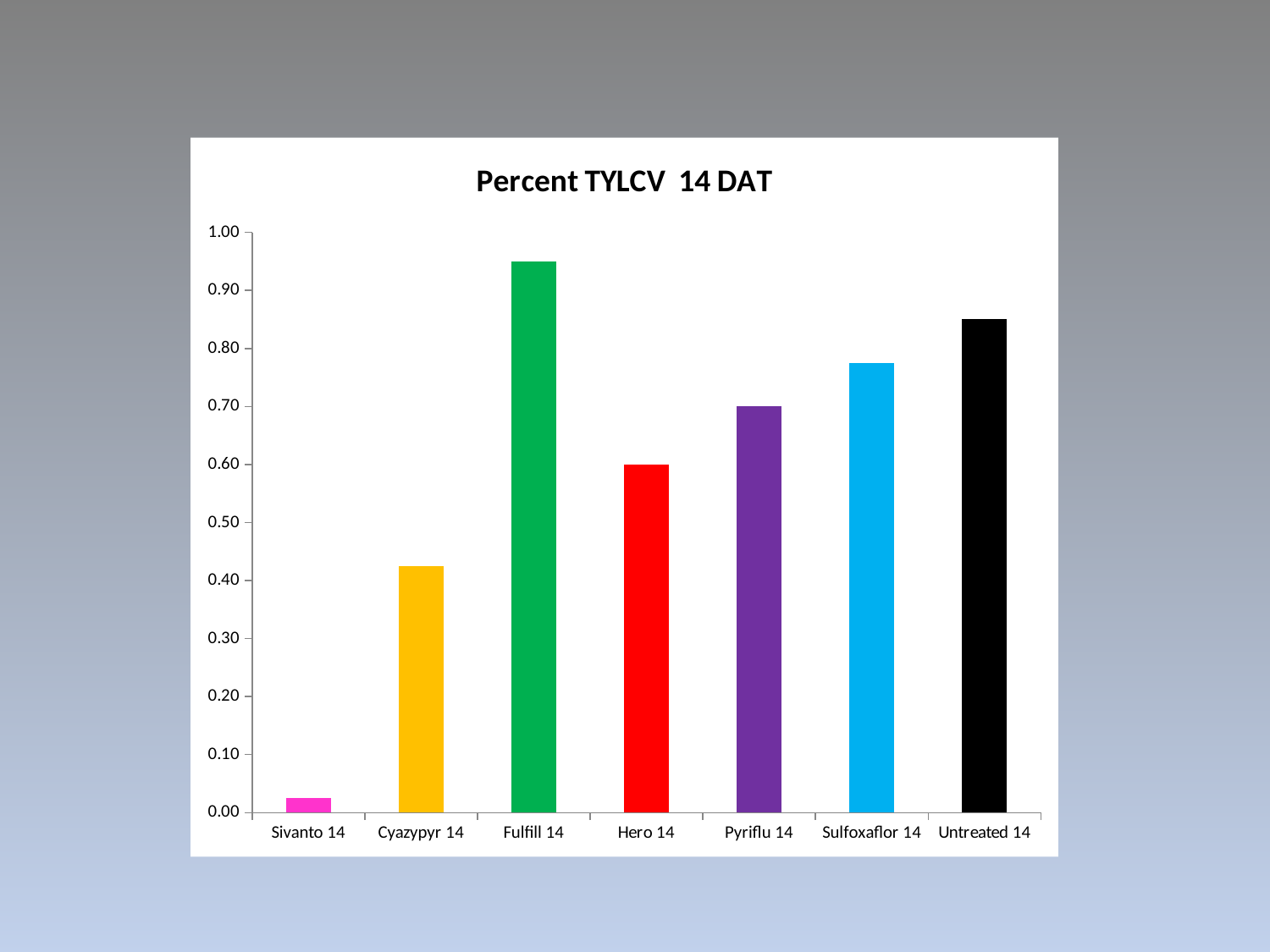
What kind of chart is shown on the slide? bar chart Which is larger, the value for Untreated 14 or the value for Sulfoxaflor 14? Untreated 14 How many categories are shown on the x axis? 7 What is the value for Pyriflu 14? 0.70 Which category has the lowest value? Sivanto 14 Is the value for Fulfill 14 greater or less than 0.90? greater What is the value for Hero 14? 0.60 Is the value for Cyazypyr 14 greater or less than 0.50? less What is the title of the chart? Percent TYLCV 14 DAT Which category has the highest value? Fulfill 14 What is the difference between the values for Pyriflu 14 and Hero 14? 0.10 Is the value for Sivanto 14 greater or less than 0.10? less